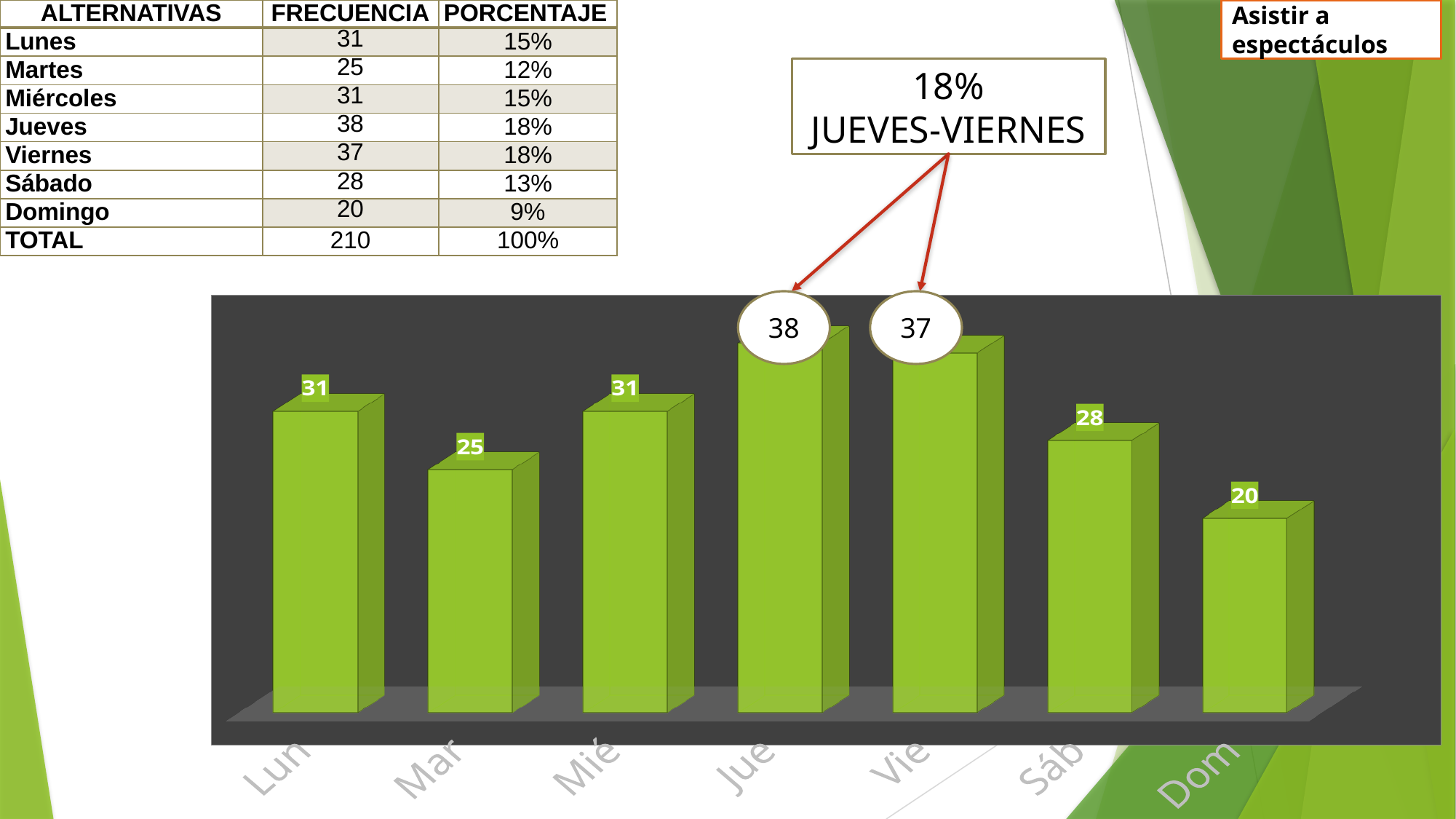
How many days (categories) are shown in the bar chart? 7 Which day has the lowest value in the bar chart? Dom What is the difference between the values for Jue and Vie? 1 What is the value for Dom (Domingo) in the bar chart? 20 What is the difference between the values for Lun and Dom? 11 Which day has the highest value in the bar chart? Jue Do the values rise or fall from Vie to Dom along the x axis? fall What percentage is shown in the callout box above the Jue and Vie bars? 18% Which is larger, the value for Sáb or the value for Mar? Sáb What kind of chart is shown on the slide? bar chart What is the value for Jue (Jueves) in the bar chart? 38 What is the value for Mar (Martes) in the bar chart? 25